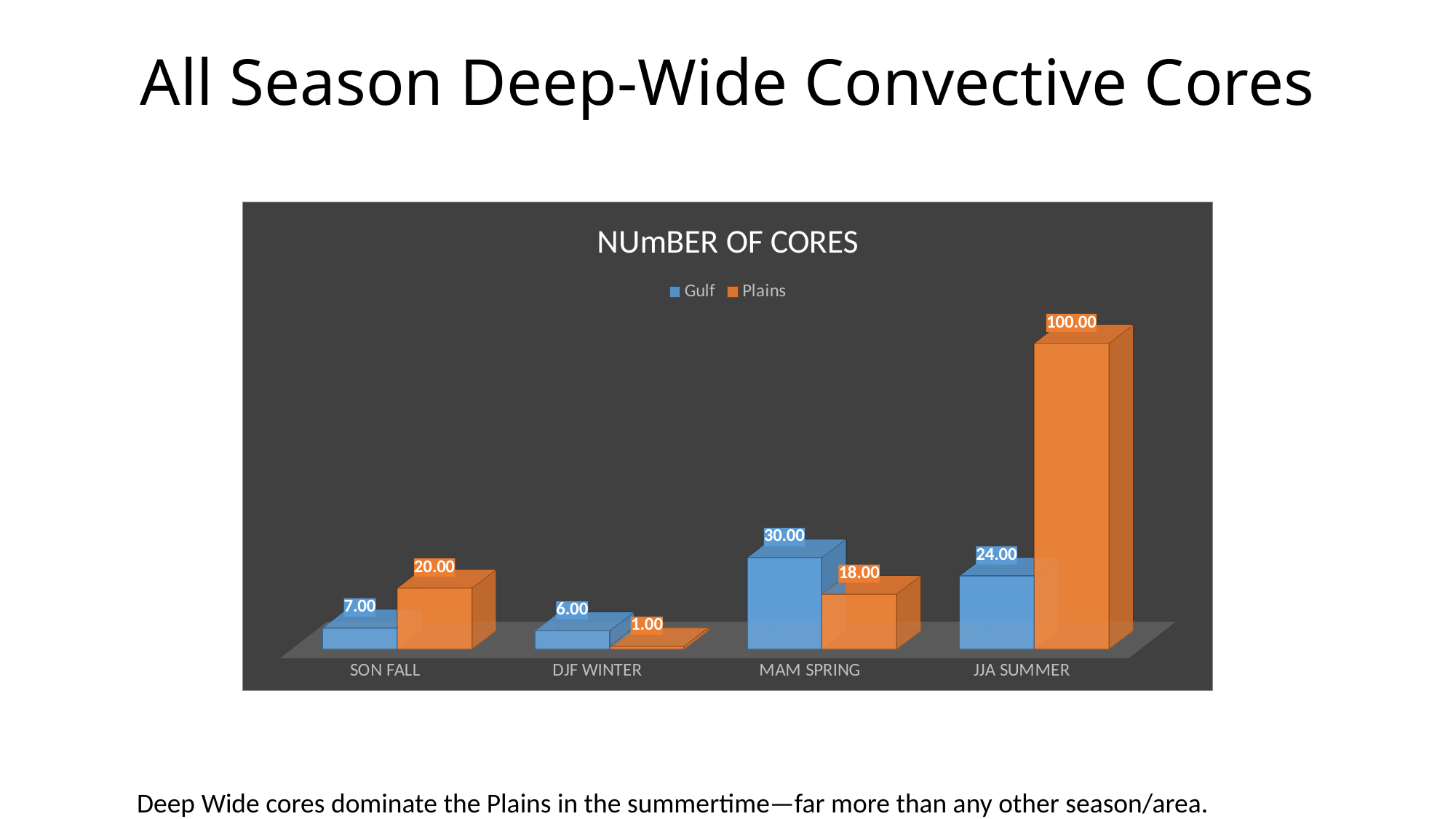
Which season has the lowest Gulf value? DJF WINTER What is the Plains value for JJA SUMMER? 100.00 How many seasons are shown on the x axis? 4 What is the difference between the Plains and Gulf values for JJA SUMMER? 76.00 Which season has the highest Plains value? JJA SUMMER What is the Gulf value for SON FALL? 7.00 What is the title of the chart? NUmBER OF CORES What is the Plains value for DJF WINTER? 1.00 What is the Gulf value for MAM SPRING? 30.00 For MAM SPRING, which series has the larger value, Gulf or Plains? Gulf What kind of chart is shown? Bar chart How many series does the legend list? 2